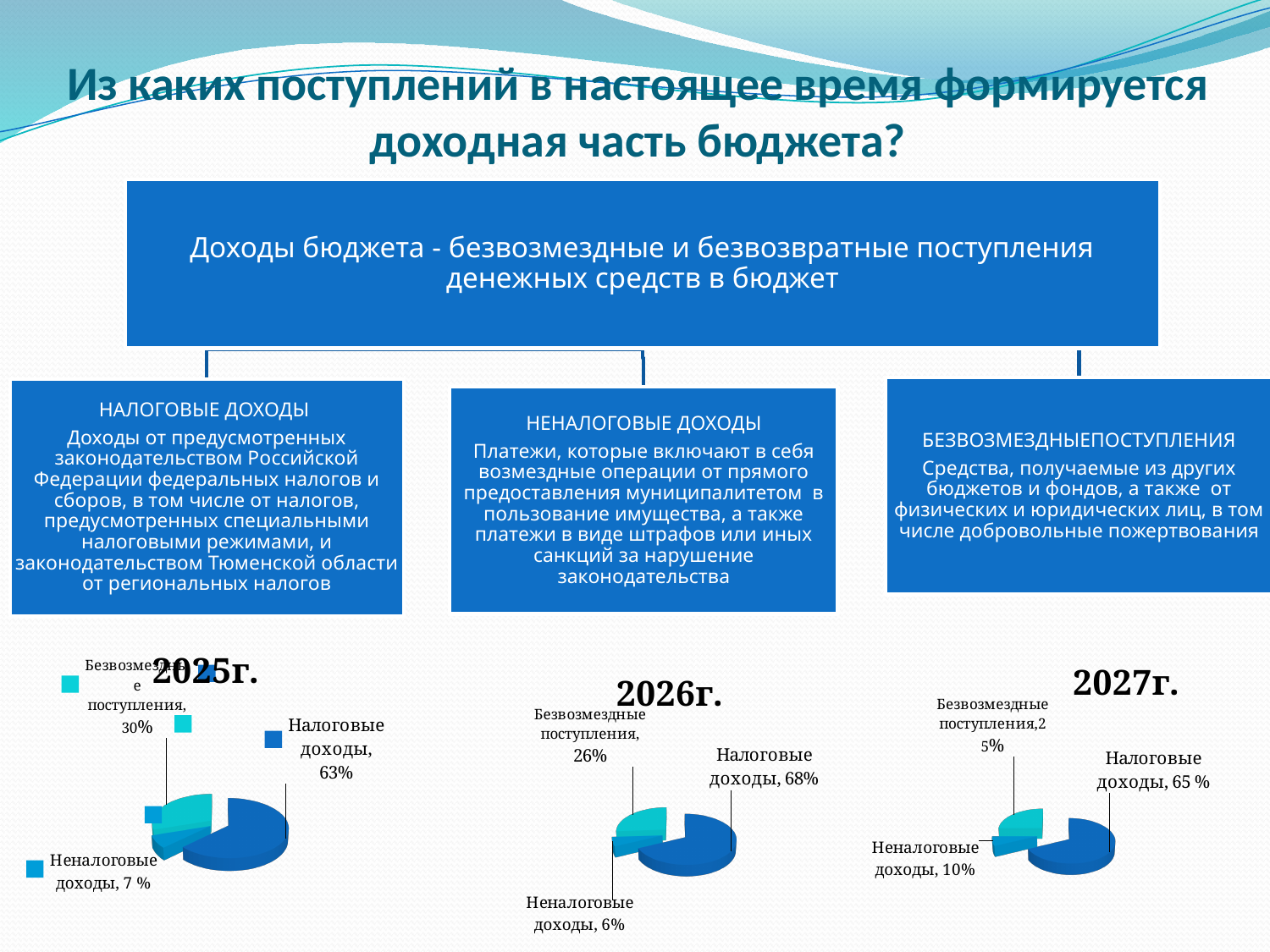
What type of chart is used for the 2026г. data? Pie chart In the 2025г. pie chart, which category has the smallest share? Неналоговые доходы How many pie charts are shown at the bottom of the slide? 3 In the 2027г. pie chart, what share is shown for Неналоговые доходы? 10% Which is larger: the Безвозмездные поступления share in 2025г. or in 2026г.? 2025г. In the 2027г. pie chart, what share is shown for Налоговые доходы? 65 % In the 2025г. pie chart, what share is shown for Неналоговые доходы? 7 % In the 2026г. pie chart, what share is shown for Безвозмездные поступления? 26% In the 2025г. pie chart, what share is shown for Налоговые доходы? 63% What is the difference between the Налоговые доходы share in 2026г. and in 2025г.? 5 percentage points In the 2026г. pie chart, which category has the largest share? Налоговые доходы How many categories does each pie chart on the slide show? 3